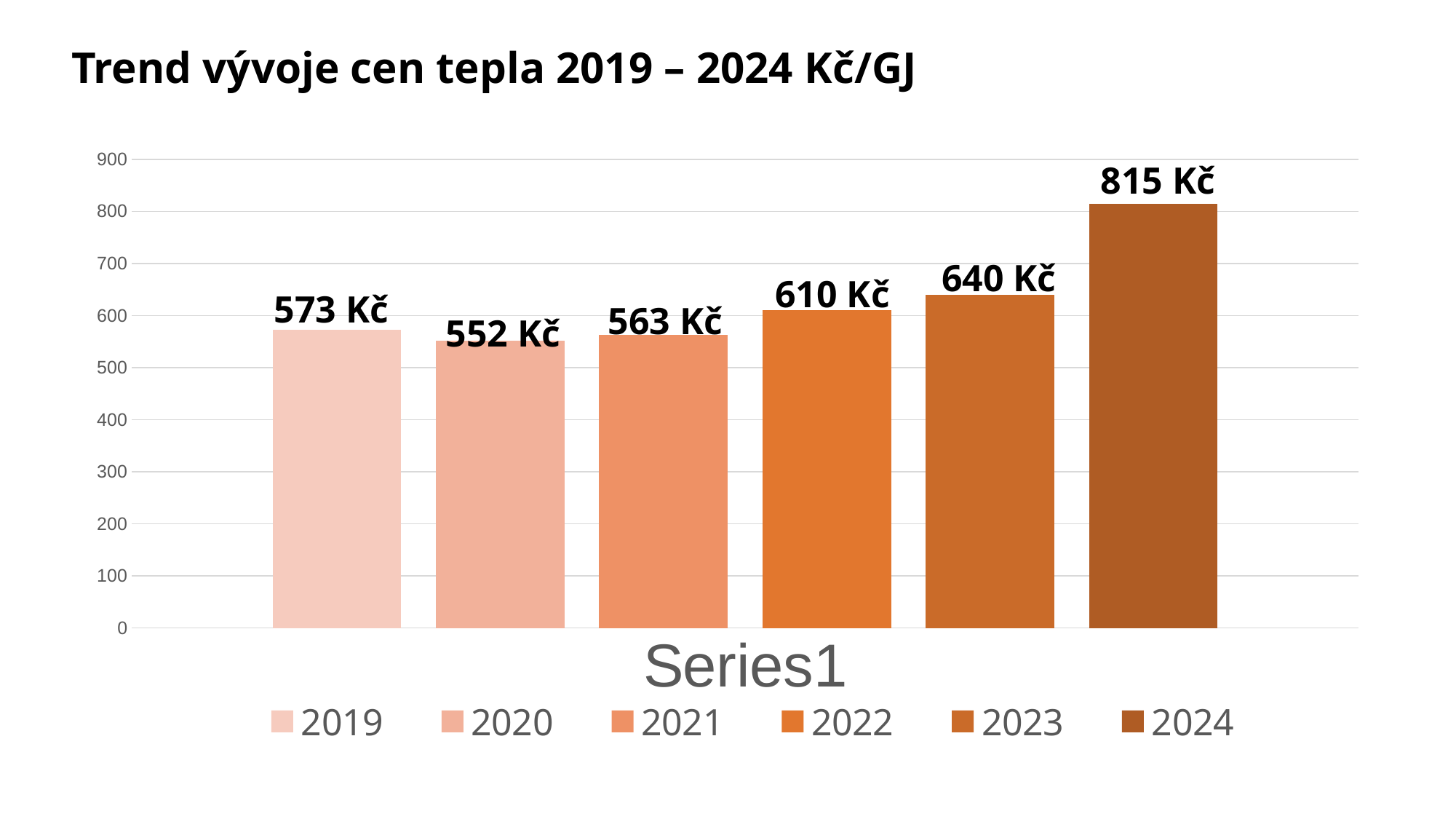
Which year has the highest value? 2024 What is the value for 2019? 573 Kč What is the title of the chart? Trend vývoje cen tepla 2019 – 2024 Kč/GJ What is the value for 2022? 610 Kč What is the difference between the values for 2019 and 2020? 21 Kč What kind of chart is shown on the slide? bar chart Which year has the lowest value? 2020 Which is larger, the value for 2021 or the value for 2022? 2022 How many bars are shown in the chart? 6 Is the value for 2023 greater or less than 700? less What is the value for 2024? 815 Kč What is the difference between the values for 2024 and 2023? 175 Kč